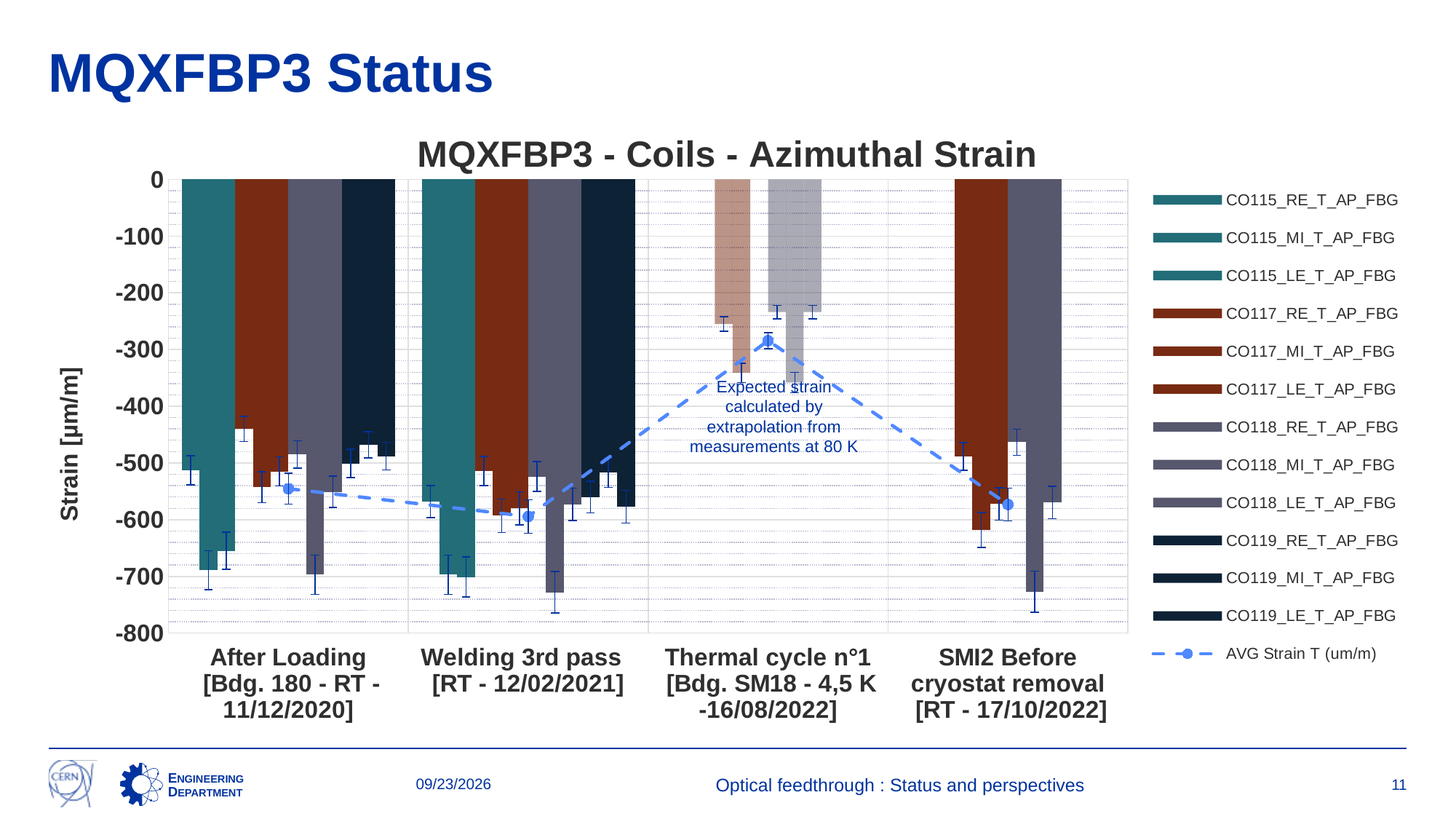
Is the value for CO118_MI_T_AP_FBG in the SMI2 Before cryostat removal category greater or less than -600? less What is the title of the chart? MQXFBP3 - Coils - Azimuthal Strain Is the value for CO115_MI_T_AP_FBG in the After Loading category greater or less than -600? less Does the AVG Strain T line rise or fall from Welding 3rd pass to Thermal cycle n°1? rises How many entries does the legend list? 13 In the After Loading category, which bar reaches a more negative strain value: CO115_RE_T_AP_FBG or CO115_MI_T_AP_FBG? CO115_MI_T_AP_FBG Is the value for CO118_RE_T_AP_FBG in the SMI2 Before cryostat removal category greater or less than -500? greater How many categories are shown along the x axis? 4 What is the label of the vertical axis? Strain [µm/m] What kind of chart is shown on the slide? Bar chart (with an average line)